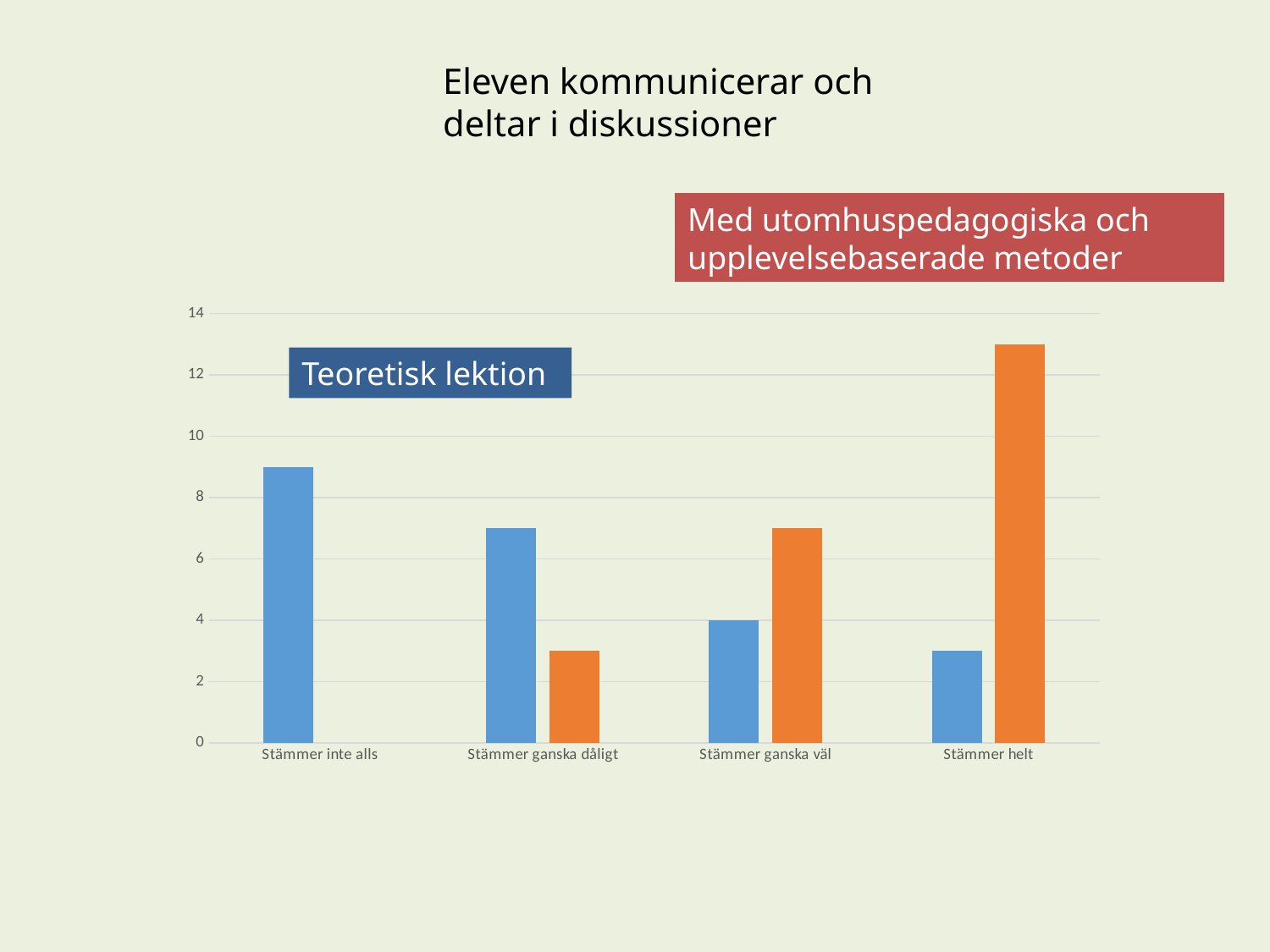
Which category has the highest value for Teoretisk lektion? Stämmer inte alls Do the values for Teoretisk lektion rise or fall from Stämmer inte alls to Stämmer helt? fall What is the value for Teoretisk lektion in the category Stämmer ganska väl? 4 What kind of chart is shown on the slide? Bar chart Which category has the lowest value for Teoretisk lektion? Stämmer helt In the category Stämmer ganska dåligt, which series has the larger value? Teoretisk lektion Which category has the highest value for Med utomhuspedagogiska och upplevelsebaserade metoder? Stämmer helt Is the value for Med utomhuspedagogiska och upplevelsebaserade metoder in the category Stämmer ganska dåligt greater or less than 4? less Is the value for Med utomhuspedagogiska och upplevelsebaserade metoder in the category Stämmer helt greater or less than 12? greater What colour are the bars for Teoretisk lektion? Blue Is the value for Teoretisk lektion in the category Stämmer inte alls greater or less than 8? greater How many categories are shown on the x axis of the chart? 4